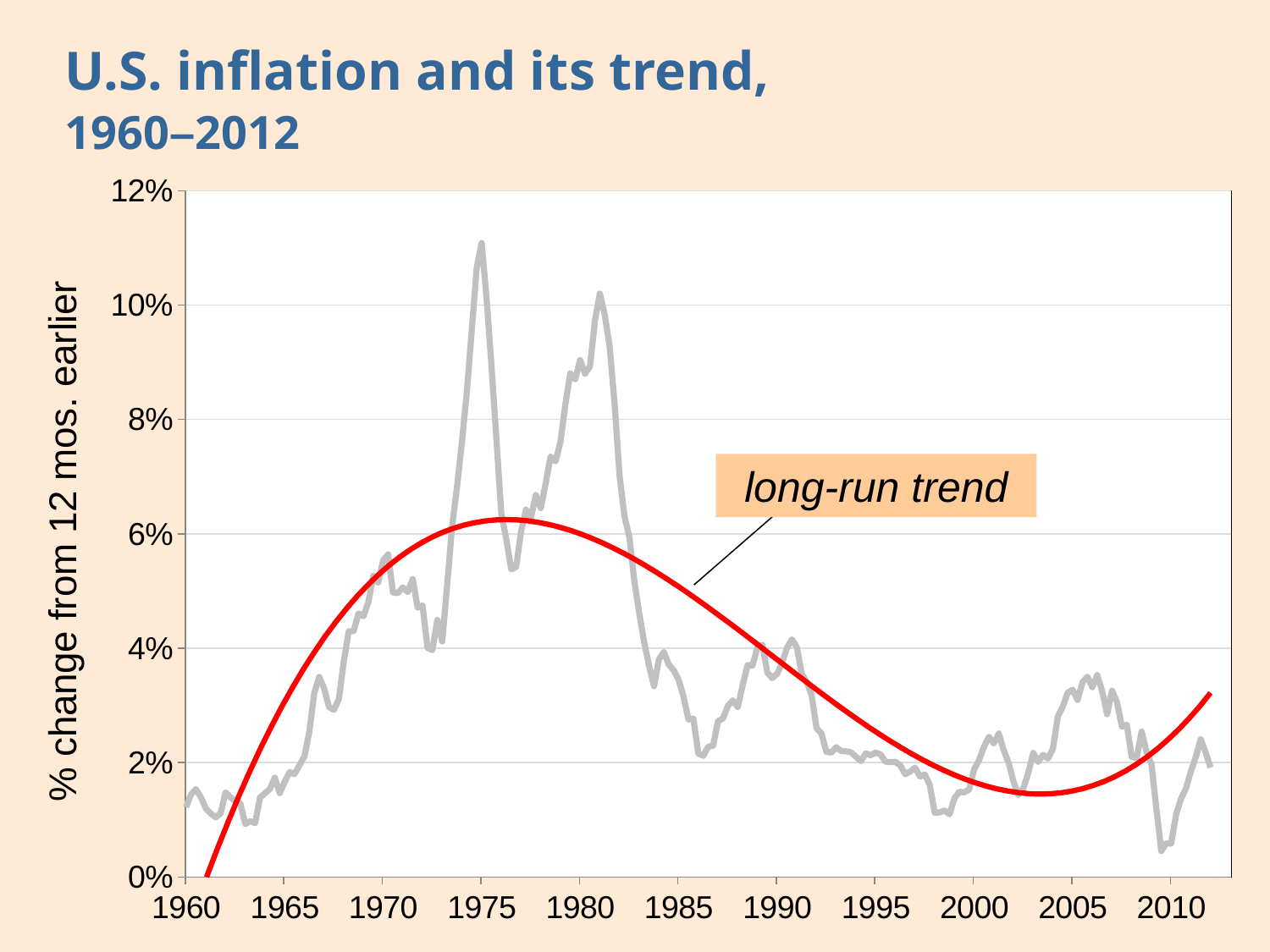
What label is given to the red line on the chart? long-run trend What kind of chart is shown on the slide? line chart Is the lowest value of the gray inflation line around 2009 greater or less than 2%? less What is the title of the chart? U.S. inflation and its trend, 1960–2012 Is the peak value of the gray inflation line around 1975 greater or less than 10%? greater Is the value of the red long-run trend line around 1976 greater or less than 4%? greater How many lines are plotted on the chart? 2 Does the red long-run trend line rise or fall between 1980 and 2000? fall Around which year does the gray inflation line reach its highest value? 1975 Which is higher on the gray inflation line: the peak around 1975 or the peak around 1980? the peak around 1975